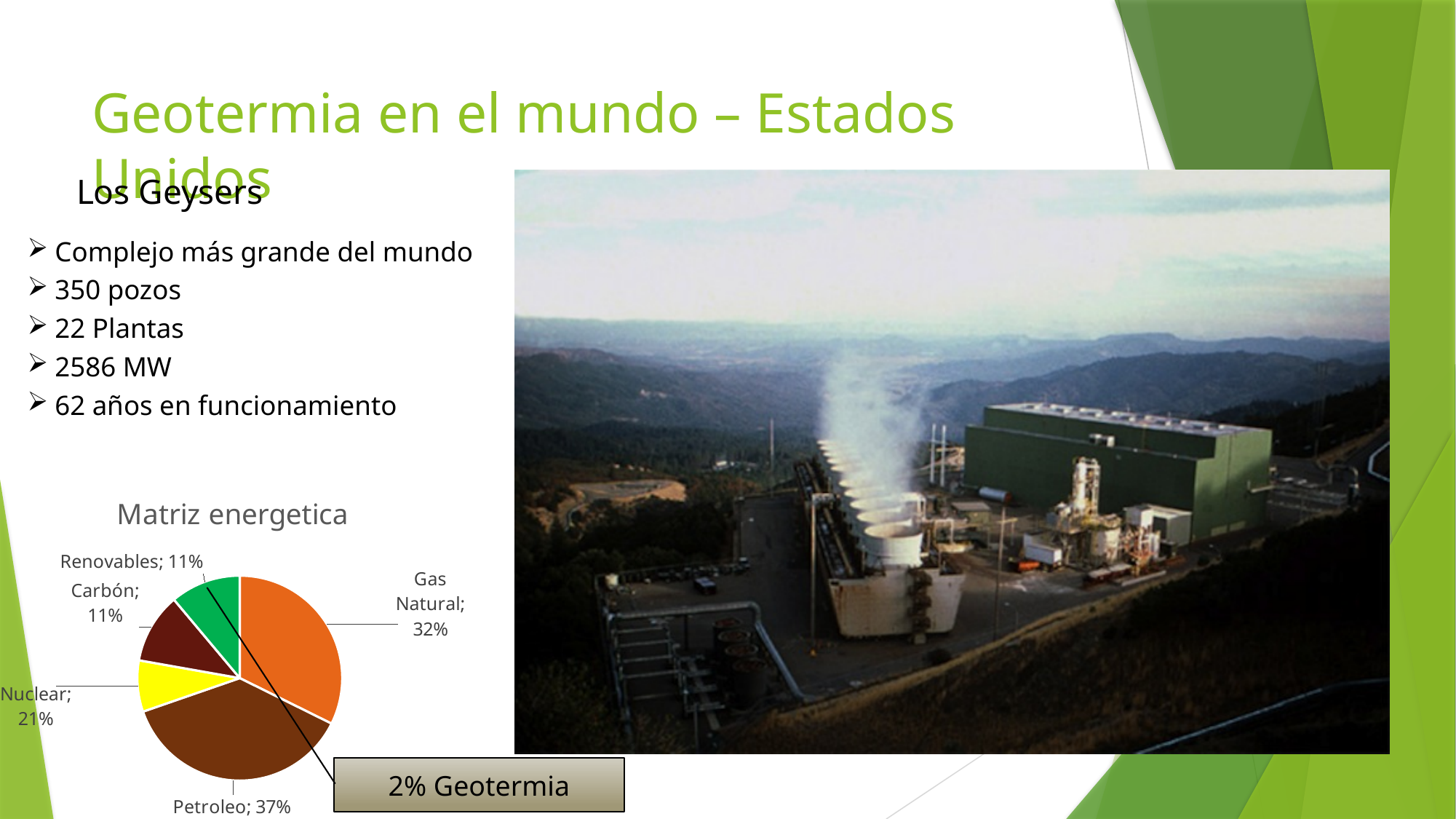
In the "Matriz energetica" pie chart, which is larger: Gas Natural or Nuclear? Gas Natural In the "Matriz energetica" pie chart, what percentage is shown for Gas Natural? 32% Which category has the largest slice in the "Matriz energetica" pie chart? Petroleo In the "Matriz energetica" pie chart, how many percentage points larger is Nuclear than Carbón? 10 What type of chart is shown under the title "Matriz energetica"? pie chart In the "Matriz energetica" pie chart, what percentage is shown for Renovables? 11% According to the callout on the "Matriz energetica" chart, what percentage corresponds to Geotermia? 2% In the "Matriz energetica" pie chart, what percentage is shown for Carbón? 11% In the "Matriz energetica" pie chart, how many percentage points larger is Petroleo than Gas Natural? 5 What is the title of the pie chart on the slide? Matriz energetica In the "Matriz energetica" pie chart, what percentage is shown for Petroleo? 37% In the "Matriz energetica" pie chart, what percentage is shown for Nuclear? 21%